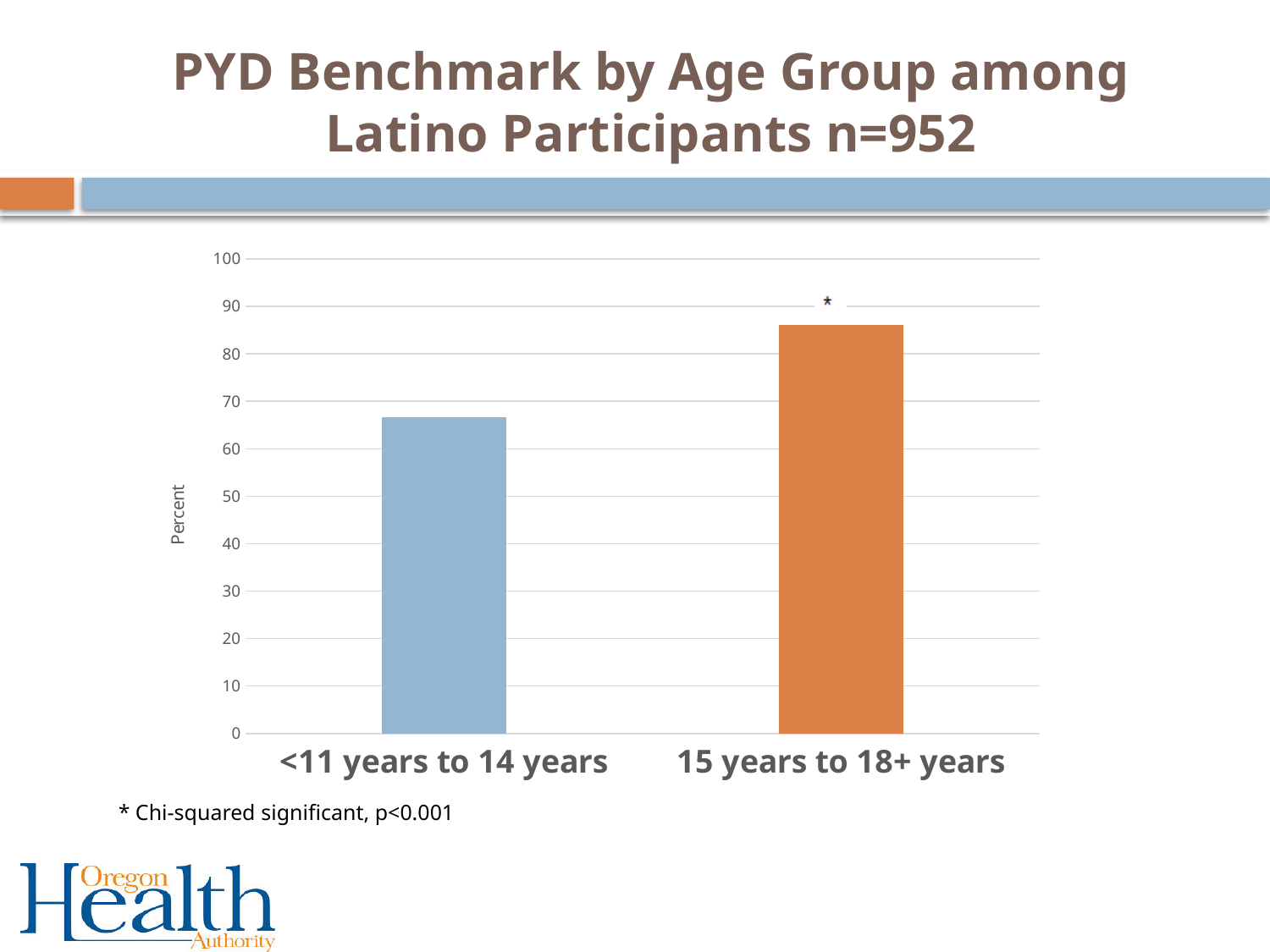
Which is larger, the value for <11 years to 14 years or the value for 15 years to 18+ years? 15 years to 18+ years What kind of chart is shown on the slide? bar chart Is the value for 15 years to 18+ years greater or less than 80? greater What is the label on the vertical axis of the chart? Percent What is the title of the chart on the slide? PYD Benchmark by Age Group among Latino Participants n=952 Is the value for 15 years to 18+ years greater or less than 90? less Which age group has the lowest value on the chart? <11 years to 14 years Is the value for <11 years to 14 years greater or less than 60? greater Which age group has the highest value on the chart? 15 years to 18+ years Do the values rise or fall from the <11 years to 14 years group to the 15 years to 18+ years group? rise How many age group categories are plotted on the chart? 2